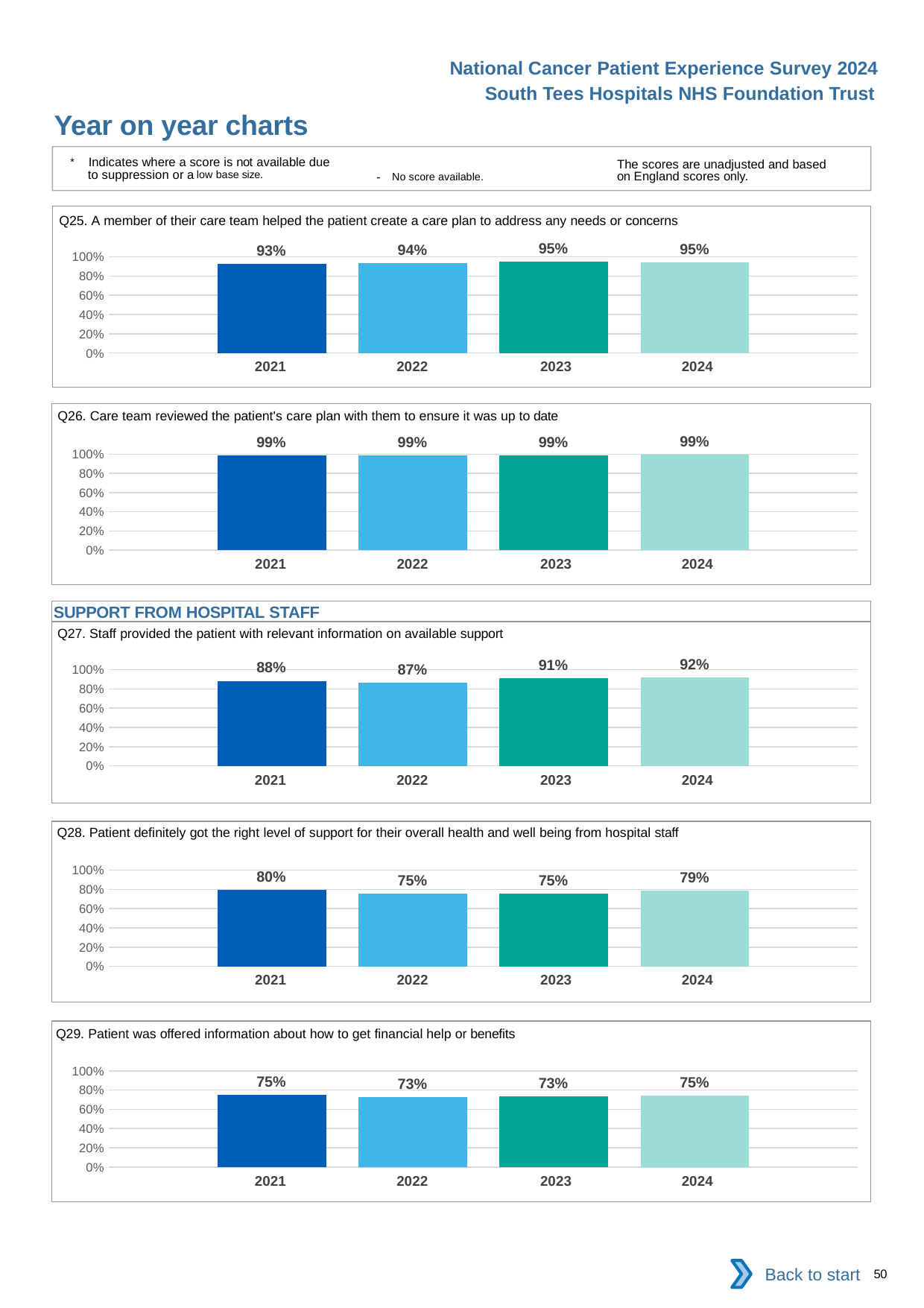
In the Q29 chart, is the value for 2023 greater or less than 80%? less In the Q27 chart, do the values rise or fall from 2022 to 2024? rise What kind of chart is the Q29 chart? bar chart In the Q28 chart, what is the difference between the 2021 and 2022 values? 5% In the Q28 chart, which is larger, the value for 2021 or the value for 2024? 2021 How many years are shown in the Q25 chart? 4 In the Q27 chart, which year has the highest value? 2024 In the Q27 chart, which year has the lowest value? 2022 In the Q25 chart, what is the value for 2021? 93% In the Q29 chart, what is the value for 2022? 73% What is the section heading shown above the Q27 chart? SUPPORT FROM HOSPITAL STAFF In the Q26 chart, what is the value for 2024? 99%